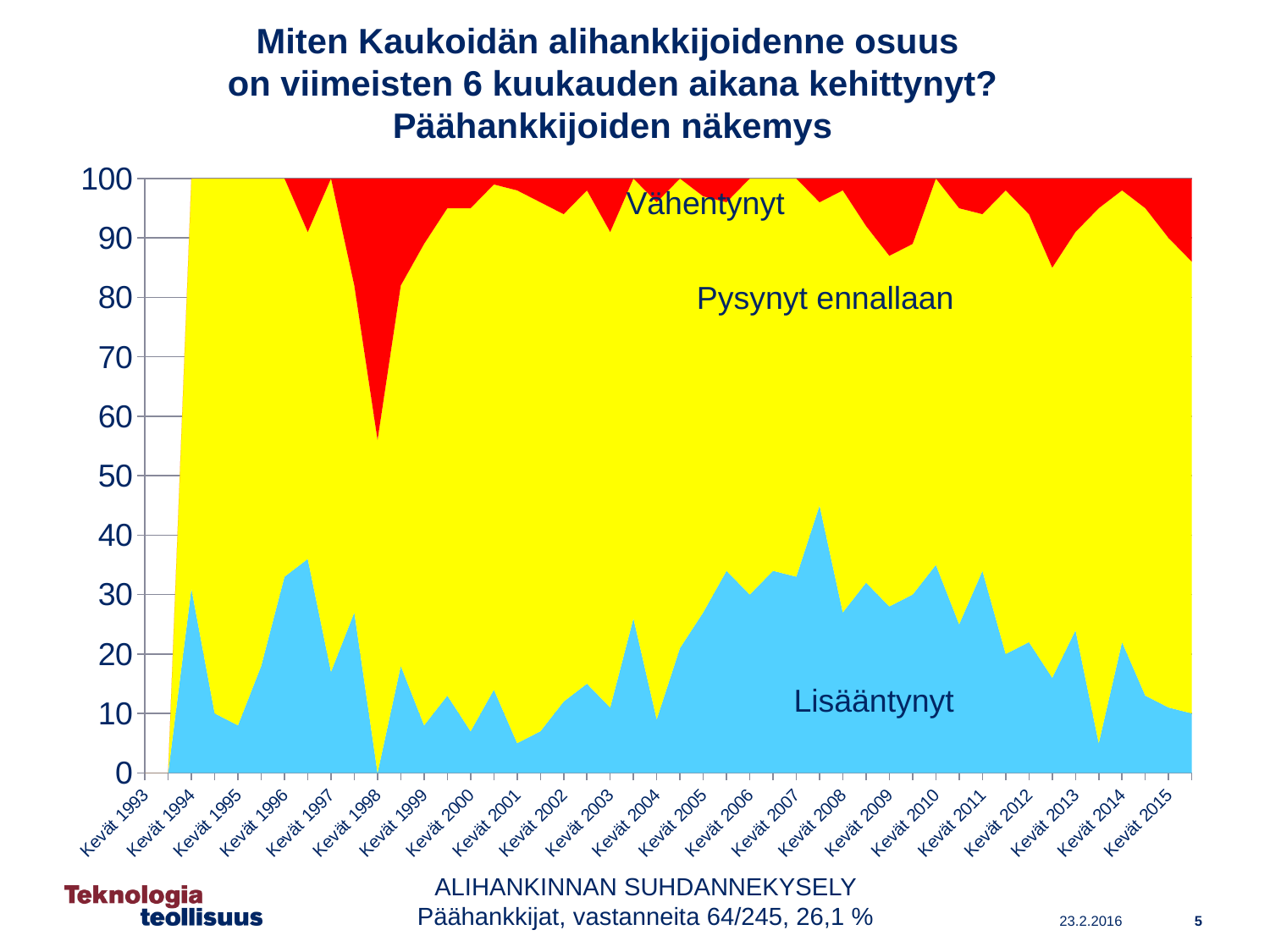
How many series are shown in the chart? 3 Is the value for Lisääntynyt at Kevät 1998 greater or less than 10? less In which year is the Vähentynyt (red) area at its largest? Kevät 1998 Is the value for Lisääntynyt at Kevät 1996 greater or less than 30? greater How many year labels are shown on the x axis of the chart? 23 What colour represents the Lisääntynyt series? Blue What kind of chart is shown on the slide? Stacked area chart Is the value for Lisääntynyt at Kevät 2008 greater or less than 40? less Which series occupies the largest share of the chart area across the years? Pysynyt ennallaan What is the first year label on the x axis? Kevät 1993